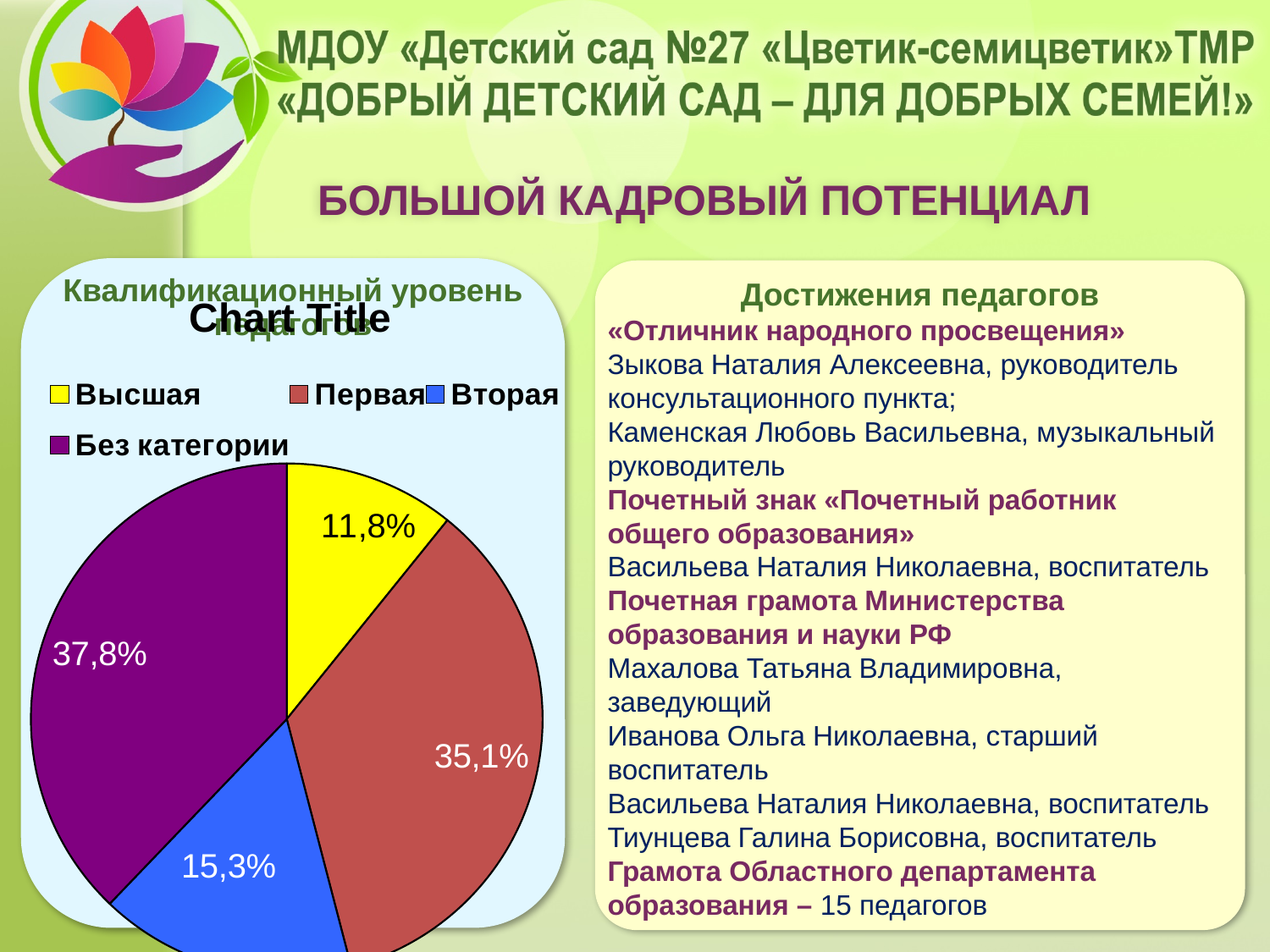
What kind of chart is shown on the slide? pie chart What share of the pie does the "Первая" slice represent? 35,1% What share of the pie does the "Без категории" slice represent? 37,8% What share of the pie does the "Высшая" slice represent? 11,8% How many entries does the chart legend list? 4 Which category has the smallest slice of the pie? Высшая What share of the pie does the "Вторая" slice represent? 15,3% How many categories does the pie chart have? 4 What colour is the "Вторая" slice in the pie chart? blue What is the difference in percentage points between the "Без категории" slice and the "Высшая" slice? 26,0 percentage points Which category has the largest slice of the pie? Без категории Which slice is larger, "Первая" or "Вторая"? Первая